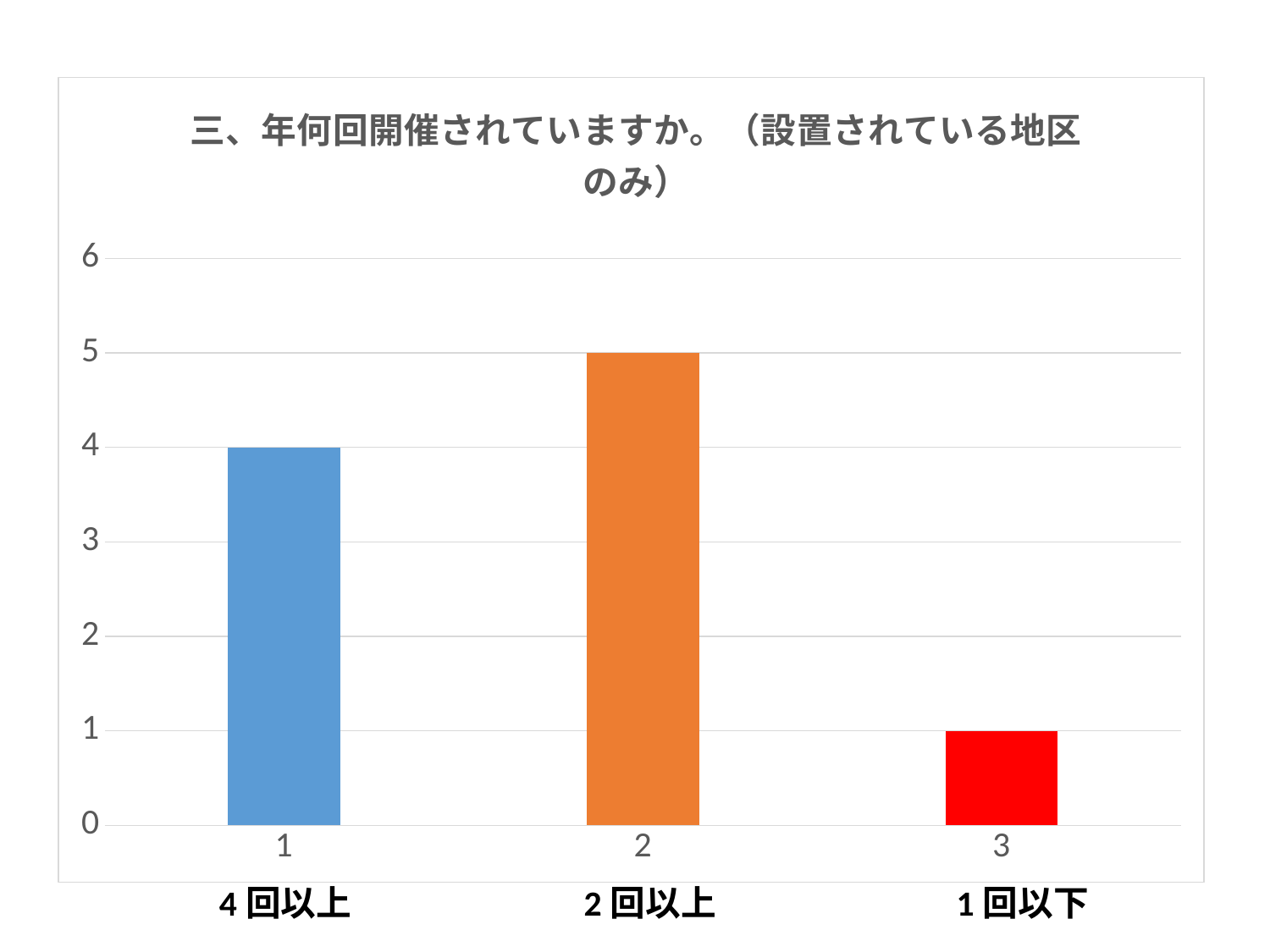
What is the value of the bar for category 2 (2回以上)? 5 What is the value of the bar for category 1 (4回以上)? 4 What is the value of the bar for category 3 (1回以下)? 1 How many bars are plotted in the chart? 3 Which category has the highest bar? 2 (2回以上) What colour is the bar for category 3 (1回以下)? red Which is larger, the value for category 1 (4回以上) or category 3 (1回以下)? category 1 (4回以上) What is the title of the chart? 三、年何回開催されていますか。（設置されている地区のみ） Which category has the lowest bar? 3 (1回以下) What is the difference between the values for category 2 (2回以上) and category 1 (4回以上)? 1 What kind of chart is shown on the slide? bar chart What is the difference between the values for category 2 (2回以上) and category 3 (1回以下)? 4